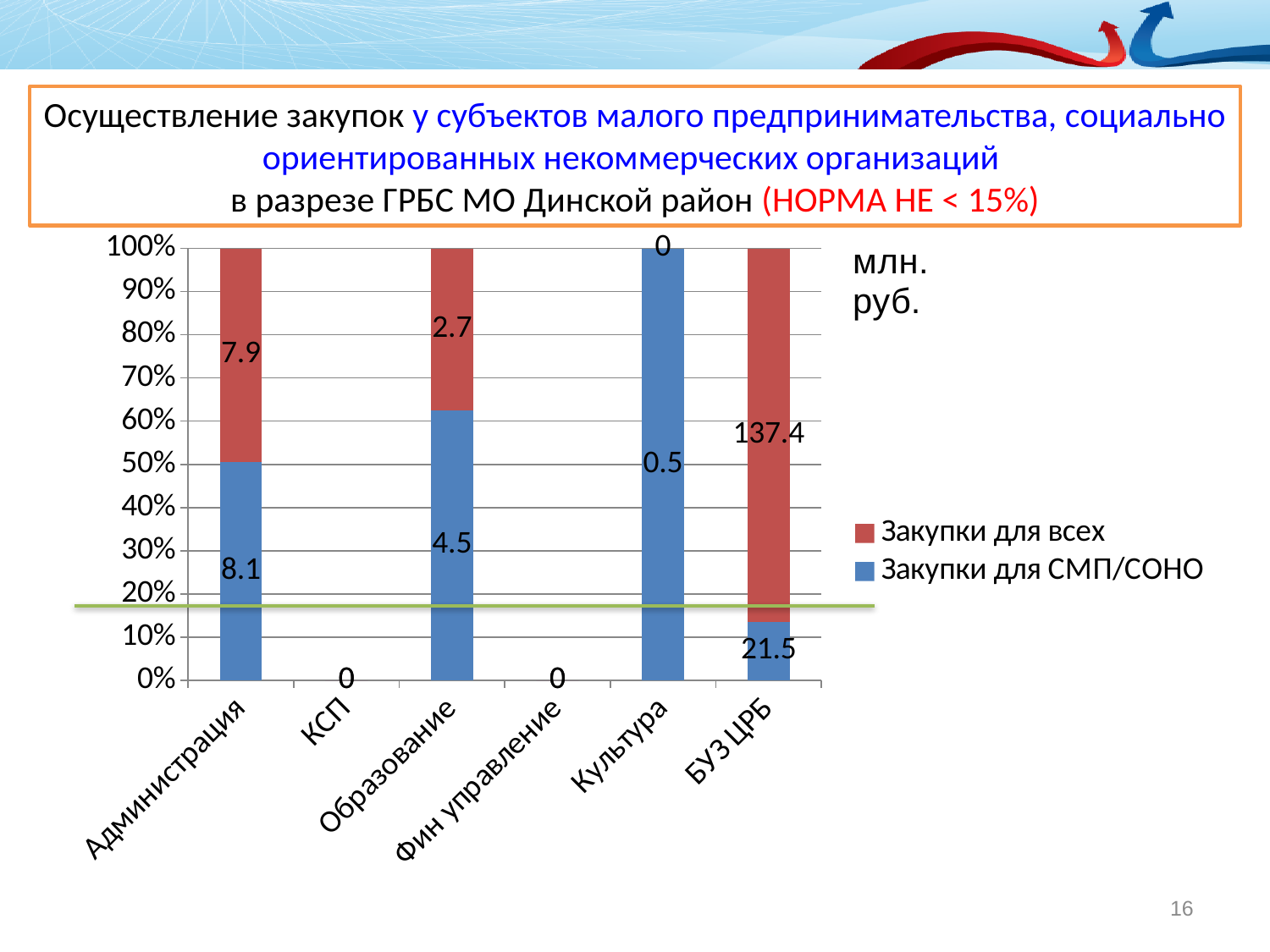
What is the value of Закупки для всех for Образование? 2.7 What is the difference between Закупки для всех and Закупки для СМП/СОНО for БУЗ ЦРБ? 115.9 For Образование, which is larger: Закупки для СМП/СОНО or Закупки для всех? Закупки для СМП/СОНО What is the total of the two labelled values for Образование? 7.2 How many series does the legend list? 2 What kind of chart is shown on the slide? stacked bar chart How many categories are shown on the x axis? 6 Which category has the highest value of Закупки для СМП/СОНО? БУЗ ЦРБ Is the share of Закупки для СМП/СОНО in the БУЗ ЦРБ bar greater or less than 20%? less What is the value of Закупки для СМП/СОНО for Культура? 0.5 What is the value of Закупки для СМП/СОНО for Администрация? 8.1 What is the value of Закупки для всех for БУЗ ЦРБ? 137.4